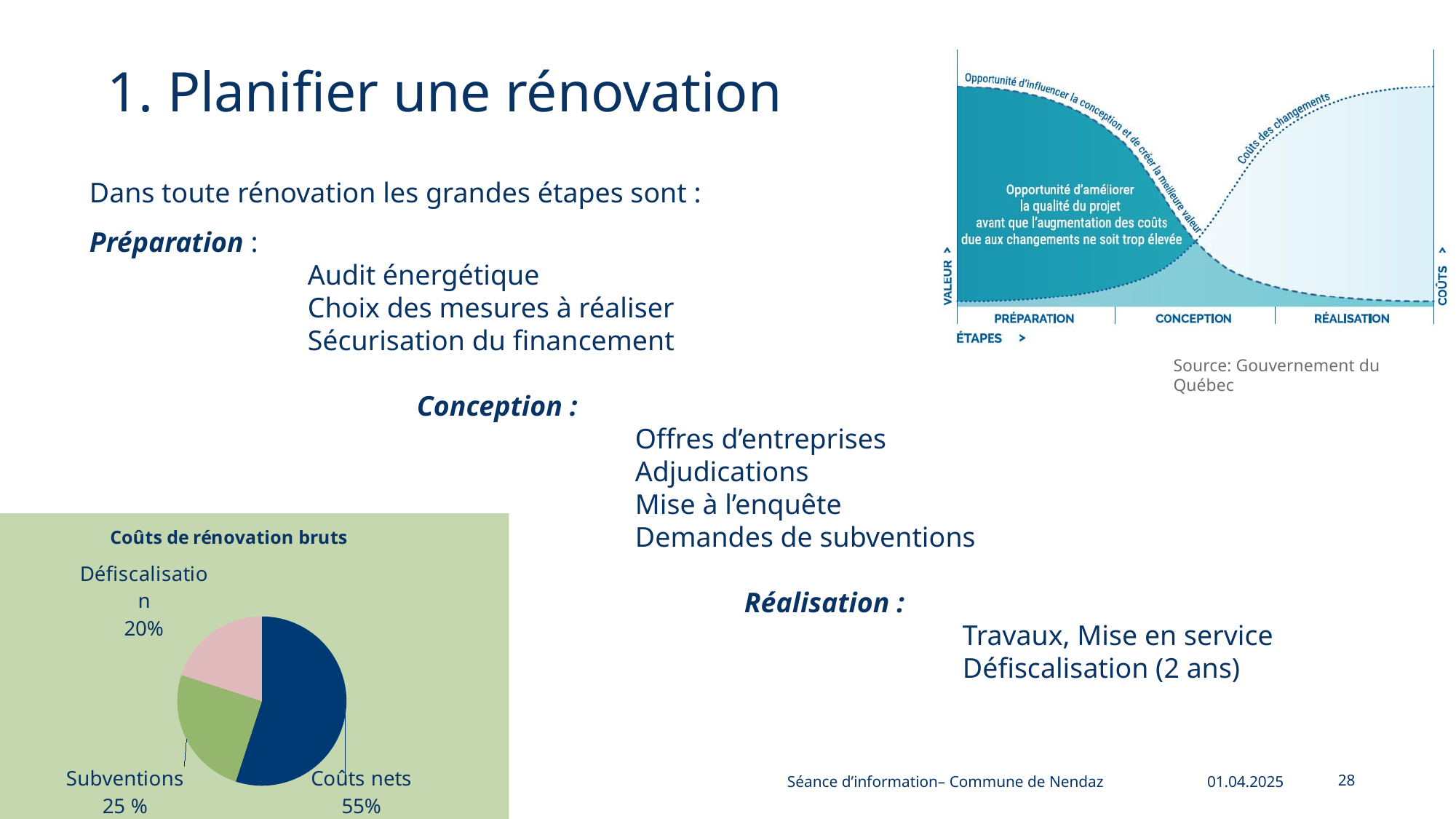
In the pie chart 'Coûts de rénovation bruts', which slice is the largest? Coûts nets In the pie chart 'Coûts de rénovation bruts', how many slices are there? 3 In the pie chart 'Coûts de rénovation bruts', what share is shown for Défiscalisation? 20% In the pie chart 'Coûts de rénovation bruts', which is larger: Subventions or Défiscalisation? Subventions In the pie chart 'Coûts de rénovation bruts', what share is shown for Coûts nets? 55% In the pie chart 'Coûts de rénovation bruts', what is the difference in percentage points between Coûts nets and Subventions? 30 In the pie chart 'Coûts de rénovation bruts', what share is shown for Subventions? 25 % What is the title of the pie chart at the bottom left of the slide? Coûts de rénovation bruts What kind of chart is 'Coûts de rénovation bruts'? Pie chart In the pie chart 'Coûts de rénovation bruts', what colour is the Coûts nets slice? Dark blue In the pie chart 'Coûts de rénovation bruts', which slice is the smallest? Défiscalisation In the pie chart 'Coûts de rénovation bruts', what is the difference in percentage points between Subventions and Défiscalisation? 5